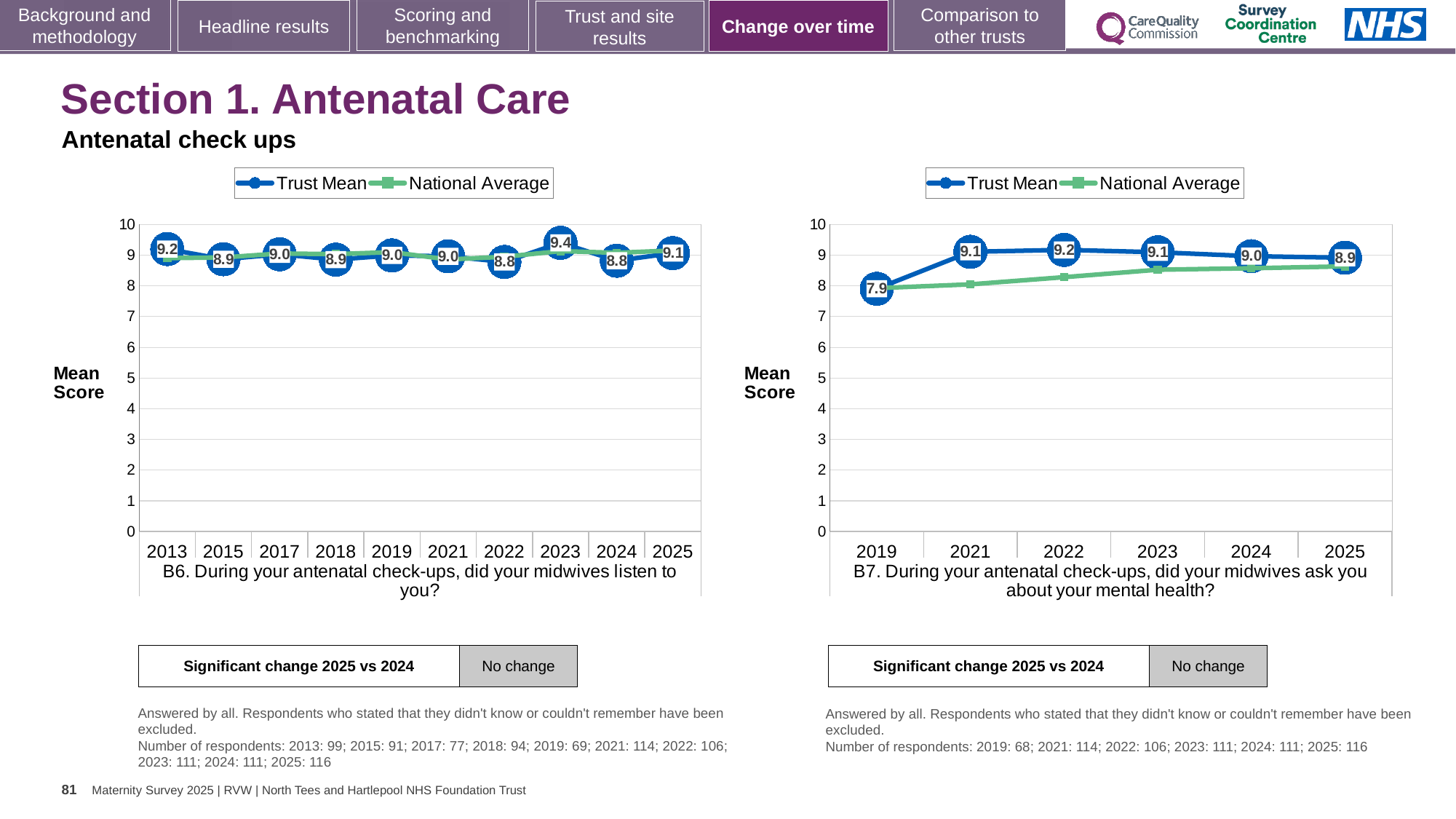
In the left chart (B6), how many years are shown on the x axis? 10 In the left chart (B6), what is the difference between the Trust Mean in 2023 and in 2024? 0.6 In the right chart (B7), which year has the lowest Trust Mean? 2019 In the right chart (B7), is the Trust Mean higher in 2021 or in 2025? 2021 In the left chart (B6), what is the Trust Mean for 2023? 9.4 How many series does the legend of the right chart (B7) list? 2 In the right chart (B7), what is the Trust Mean for 2019? 7.9 In the left chart (B6), what is the Trust Mean for 2013? 9.2 In the right chart (B7), is the National Average for 2019 greater or less than 9? less In the right chart (B7), what is the difference between the Trust Mean in 2022 and in 2019? 1.3 In the left chart (B6), which year has the highest Trust Mean? 2023 In the right chart (B7), which year has the highest Trust Mean? 2022